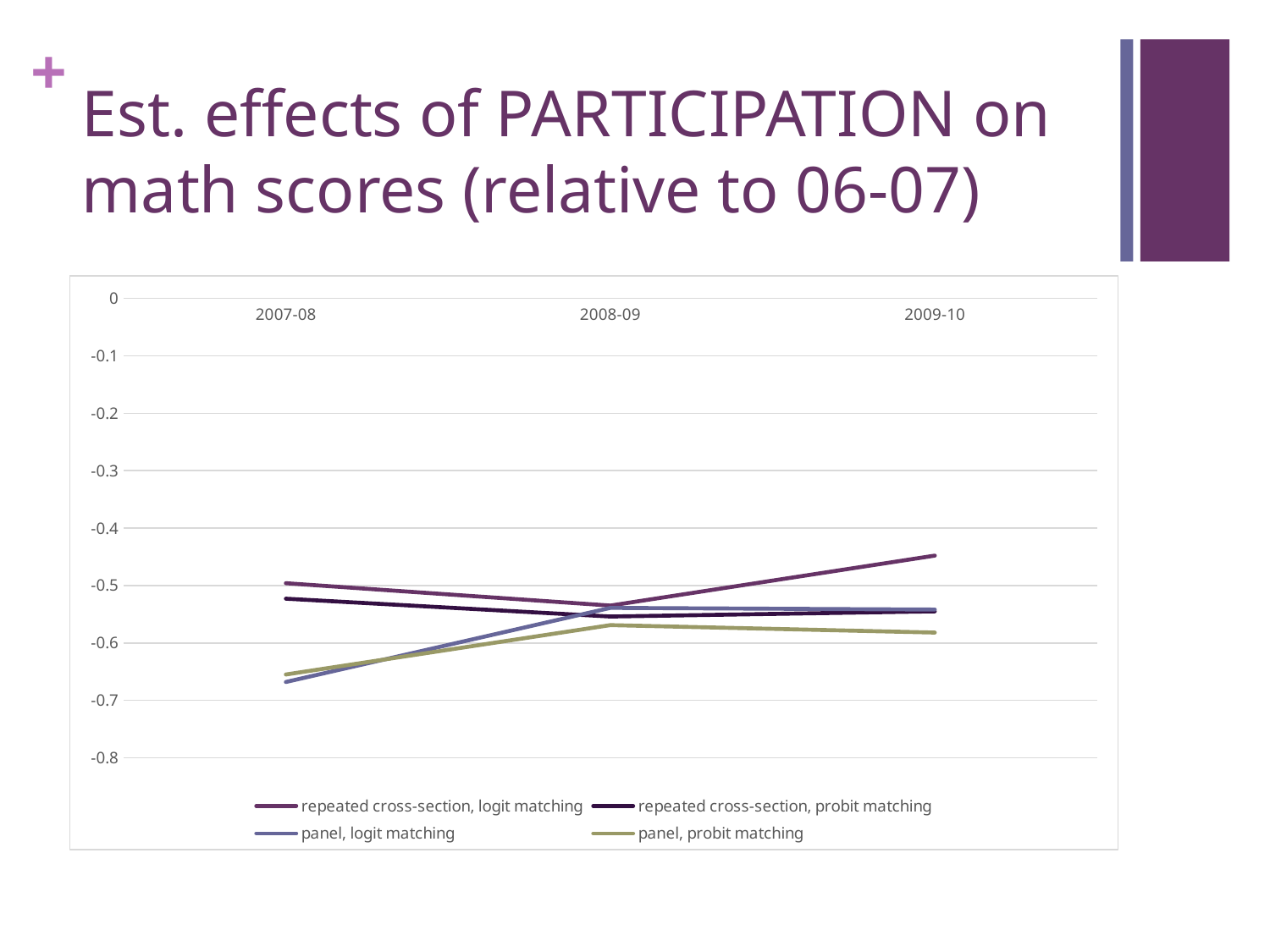
How many school years are shown on the x axis? 3 Which series has the highest value in 2007-08? repeated cross-section, logit matching What kind of chart is shown on the slide? line chart Does the panel, logit matching series rise or fall from 2007-08 to 2009-10? rise In 2007-08, which is larger: the value for repeated cross-section, logit matching or the value for panel, logit matching? repeated cross-section, logit matching Which series has the lowest value in 2009-10? panel, probit matching Which series is drawn in green? panel, probit matching How many series does the legend list? 4 What is the title of the slide? Est. effects of PARTICIPATION on math scores (relative to 06-07) Is the value for panel, logit matching in 2007-08 greater or less than -0.6? less Is the value for repeated cross-section, probit matching in 2007-08 greater or less than -0.5? less Is the value for repeated cross-section, logit matching in 2009-10 greater or less than -0.5? greater